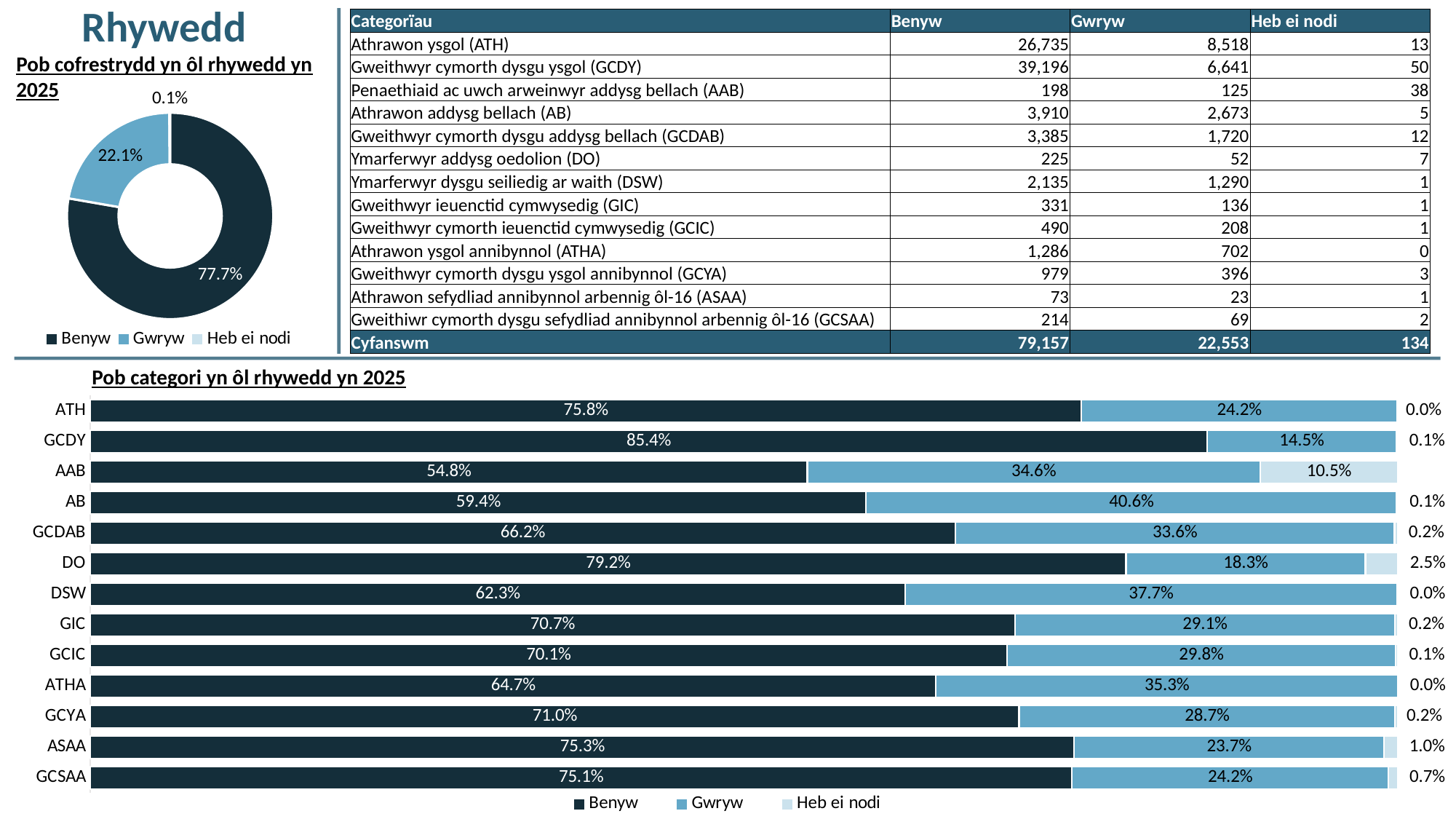
In the bar chart 'Pob categori yn ôl rhywedd yn 2025', what is the Benyw value for GCDY? 85.4% In the bar chart 'Pob categori yn ôl rhywedd yn 2025', what is the difference between the Benyw share for DO and the Benyw share for DSW? 16.9% In the bar chart 'Pob categori yn ôl rhywedd yn 2025', what is the Heb ei nodi value for AAB? 10.5% In the donut chart 'Pob cofrestrydd yn ôl rhywedd yn 2025', what share is Benyw? 77.7% In the bar chart 'Pob categori yn ôl rhywedd yn 2025', which category has the lowest Benyw share? AAB In the bar chart 'Pob categori yn ôl rhywedd yn 2025', which category has the highest Benyw share? GCDY In the donut chart 'Pob cofrestrydd yn ôl rhywedd yn 2025', what share is Gwryw? 22.1% What kind of chart is 'Pob categori yn ôl rhywedd yn 2025'? Stacked bar chart In the donut chart 'Pob cofrestrydd yn ôl rhywedd yn 2025', which category has the smallest share? Heb ei nodi How many series does the legend of the donut chart 'Pob cofrestrydd yn ôl rhywedd yn 2025' list? 3 In the bar chart 'Pob categori yn ôl rhywedd yn 2025', what is the Gwryw value for AB? 40.6% How many categories are shown in the bar chart 'Pob categori yn ôl rhywedd yn 2025'? 13